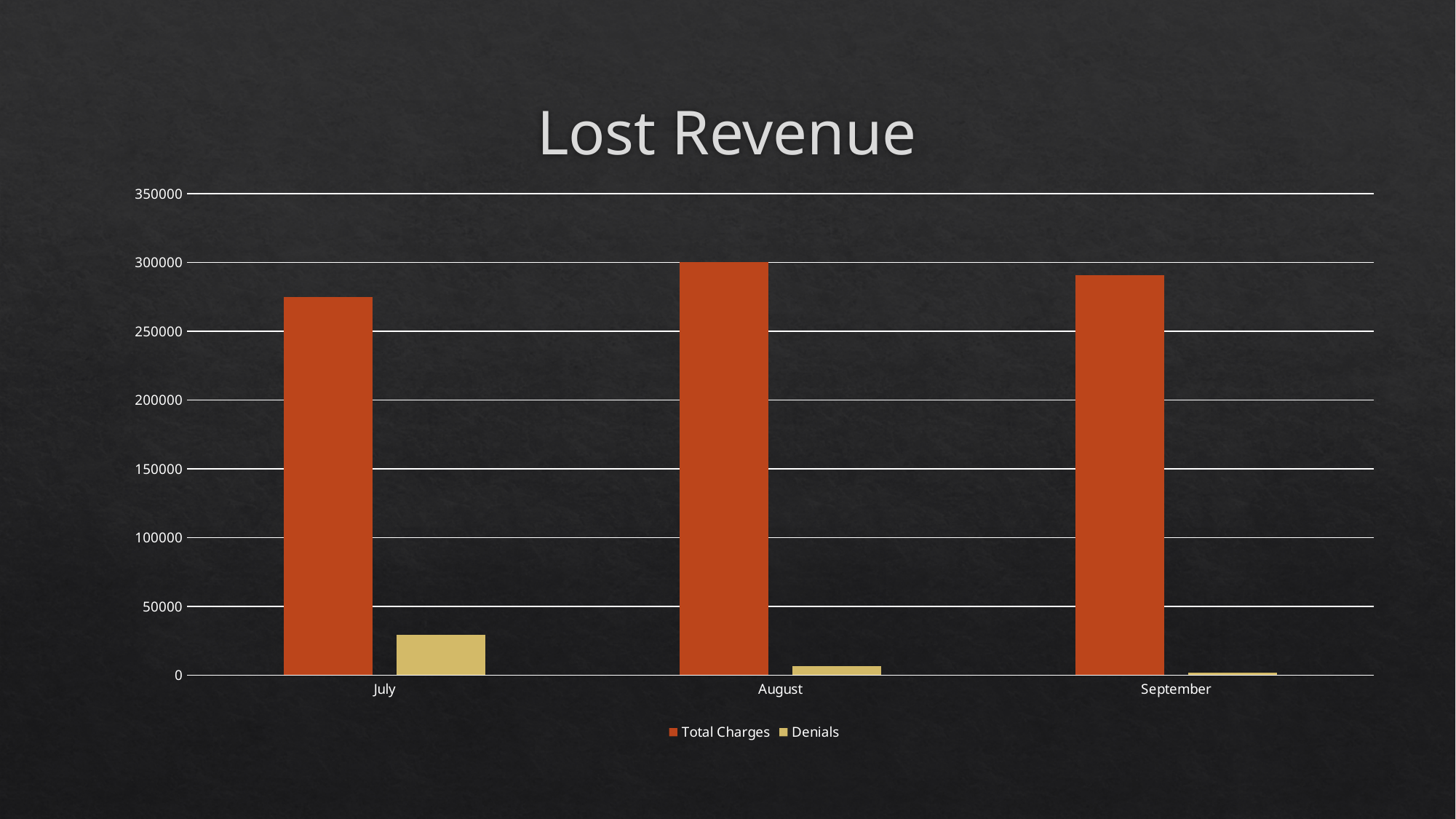
Do the Denials values rise or fall from July to September? fall Which month has the lowest Denials? September What kind of chart is shown on the slide? bar chart Which month has the highest Total Charges? August Which month has the highest Denials? July What is the title of the chart? Lost Revenue Which month has the lowest Total Charges? July Is the value of Denials for July greater or less than 50000? less How many months are shown on the x axis? 3 How many series does the legend list? 2 Is the value of Total Charges for July greater or less than 250000? greater